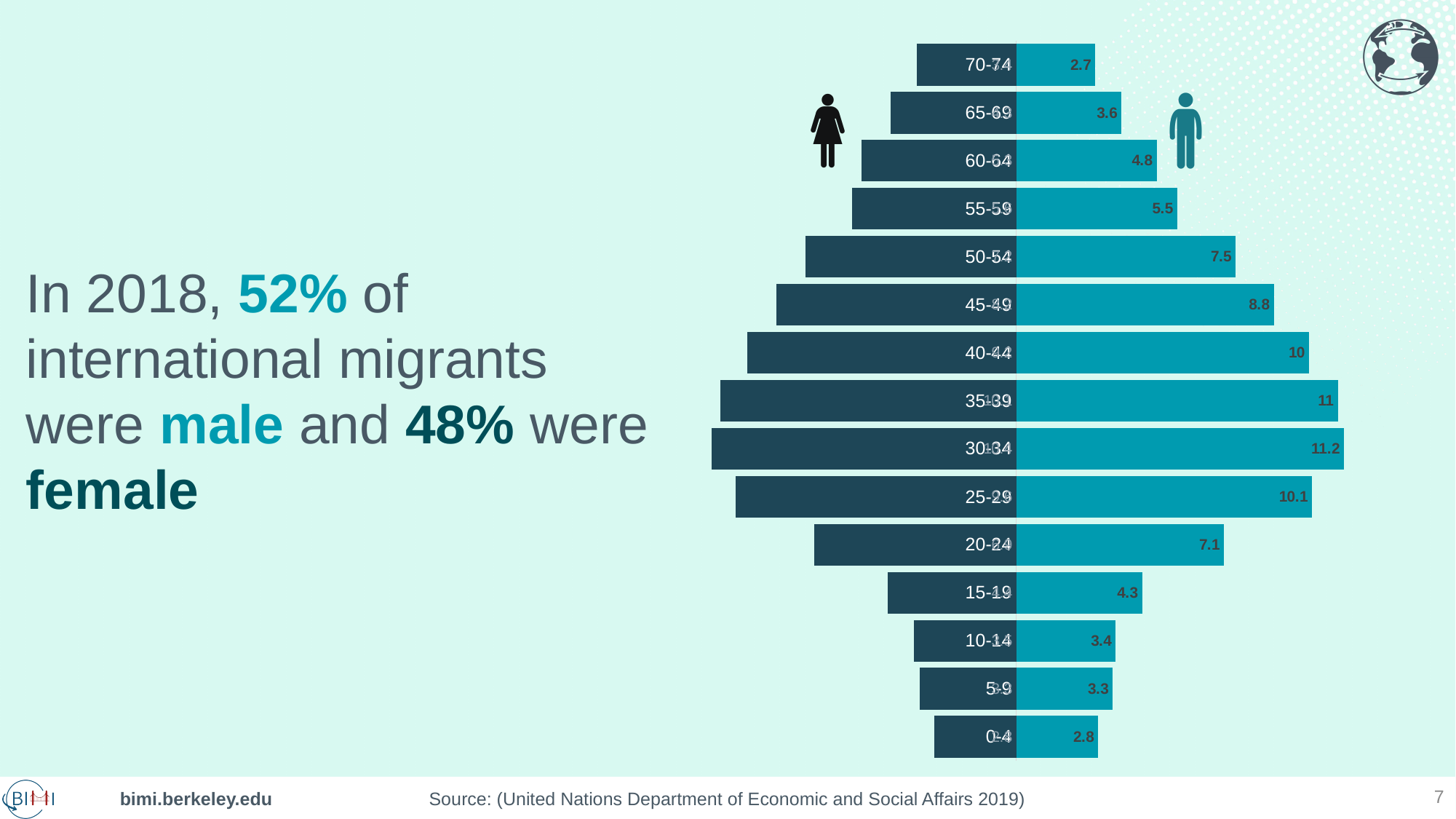
How many age groups are shown in the chart? 15 Which side of the chart shows the male values? The right side What is the male value for the 50-54 age group? 7.5 Do the male values rise or fall from the 0-4 age group to the 30-34 age group? Rise What is the difference between the male values for the 35-39 and 25-29 age groups? 0.9 Which age group has the lowest male value? 70-74 What is the male value for the 70-74 age group? 2.7 What is the male value for the 0-4 age group? 2.8 What is the male value for the 30-34 age group? 11.2 What kind of chart is shown on the slide? Bar chart (population pyramid) Which age group has a larger male value, 20-24 or 45-49? 45-49 Which age group has the highest male value? 30-34